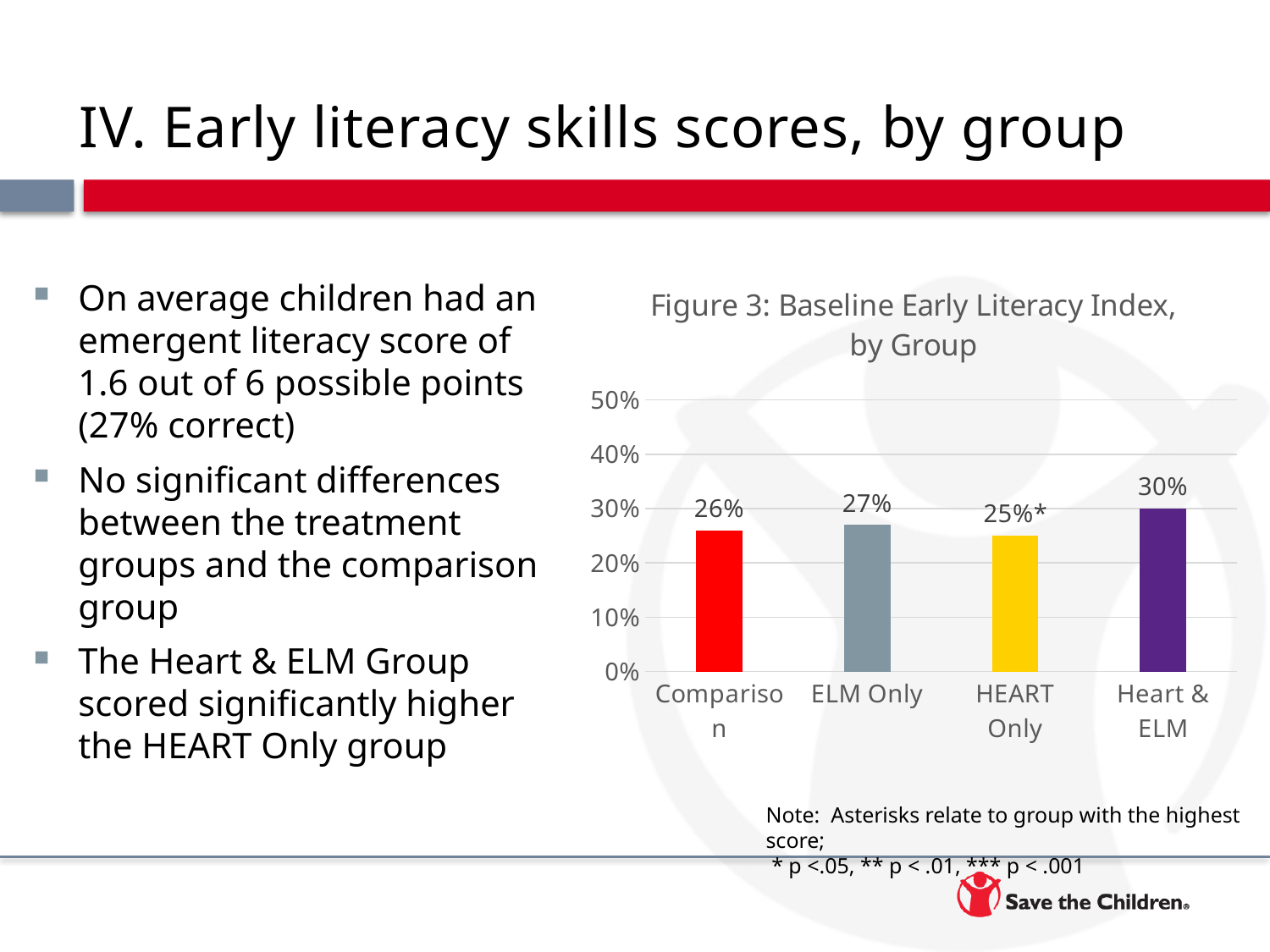
How many groups are shown on the chart? 4 Which group has the highest baseline early literacy index? Heart & ELM What kind of chart is shown on the slide? bar chart Which group has the lowest baseline early literacy index? HEART Only What is the value for the Comparison group? 26% What is the difference between the Heart & ELM value and the HEART Only value? 5% What is the value for the HEART Only group? 25%* Is the value for Heart & ELM greater or less than 20%? greater What is the value for the Heart & ELM group? 30% Which is larger, the value for ELM Only or the value for Comparison? ELM Only What is the title of the chart? Figure 3: Baseline Early Literacy Index, by Group What is the value for the ELM Only group? 27%